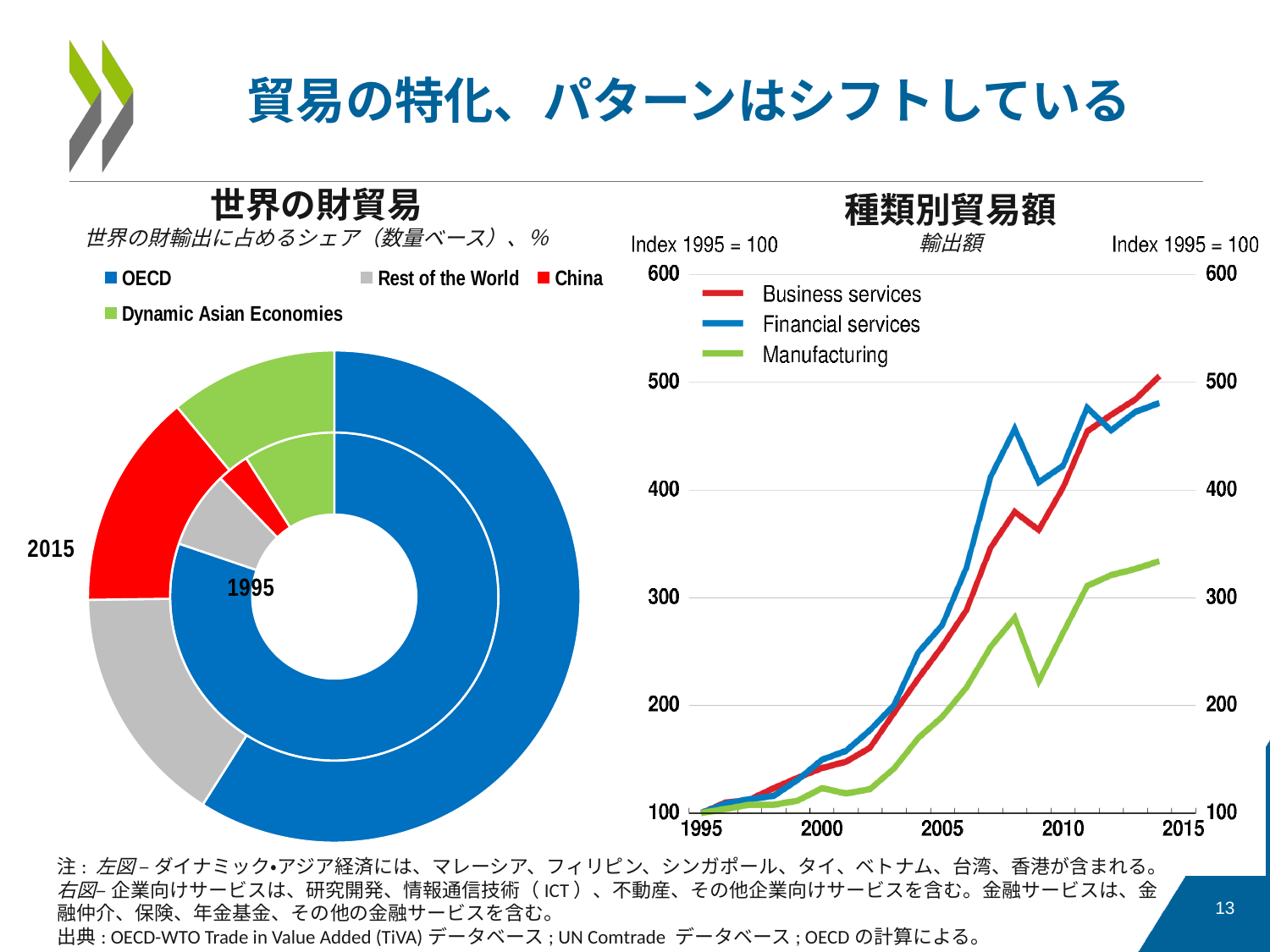
In the right chart (種類別貿易額), which series has the lowest value in 2014? Manufacturing In the left chart (世界の財貿易), how many categories does the legend list? 4 In the right chart (種類別貿易額), do the series generally rise or fall from 1995 to 2015? Rise What kind of chart is the right chart titled 種類別貿易額? Line chart In the right chart (種類別貿易額), how many series does the legend list? 3 In the left chart (世界の財貿易), which category has the smallest share of the 1995 inner ring? China In the right chart (種類別貿易額), is the value for Financial services in 2008 greater or less than 400? greater In the right chart (種類別貿易額), is the value for Manufacturing in 2014 greater or less than 400? less In the left chart (世界の財貿易), which category has the largest share of the 2015 outer ring? OECD In the right chart (種類別貿易額), which is higher in 2008, Financial services or Business services? Financial services In the left chart (世界の財貿易), is China's share larger in 1995 or in 2015? 2015 What kind of chart is the left chart titled 世界の財貿易? Doughnut (pie) chart